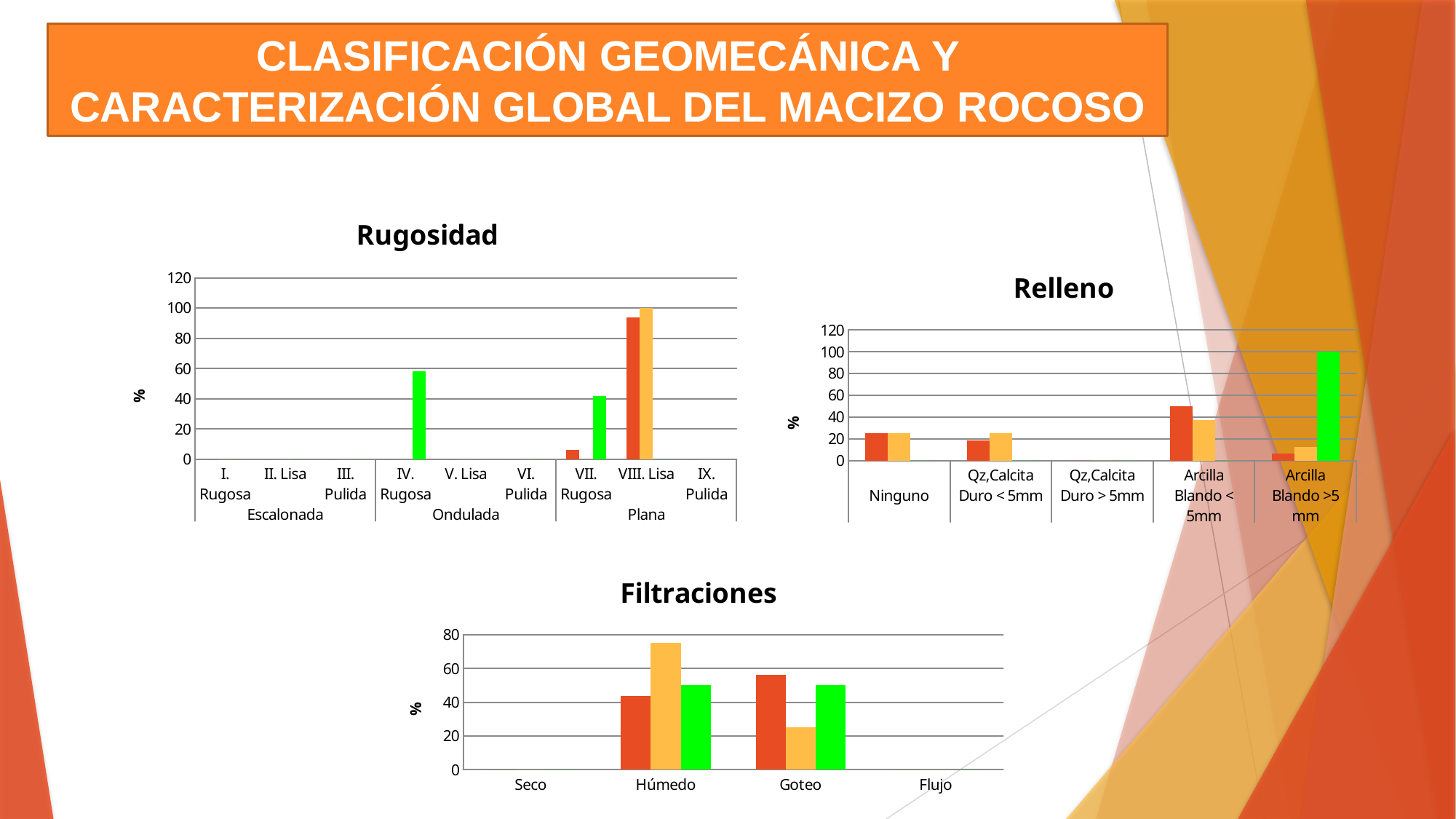
In the 'Filtraciones' chart, how many categories are shown on the x axis? 4 In the 'Filtraciones' chart, which is larger: the yellow bar for Húmedo or the yellow bar for Goteo? Húmedo In the 'Relleno' chart, is the red bar for Arcilla Blando < 5mm greater or less than 40? greater In the 'Rugosidad' chart, is the green bar for IV. Rugosa greater or less than 40? greater In the 'Rugosidad' chart, what are the three group labels shown below the categories? Escalonada, Ondulada, Plana In the 'Relleno' chart, how many categories are shown on the x axis? 5 In the 'Relleno' chart, which category has no bars at all? Qz,Calcita Duro > 5mm In the 'Rugosidad' chart, how many categories are shown on the x axis? 9 In the 'Relleno' chart, which category has the tallest bar? Arcilla Blando >5 mm What kind of chart is the 'Rugosidad' chart? bar chart In the 'Rugosidad' chart, which category has the tallest bar? VIII. Lisa In the 'Filtraciones' chart, is the yellow bar for Húmedo greater or less than 60? greater